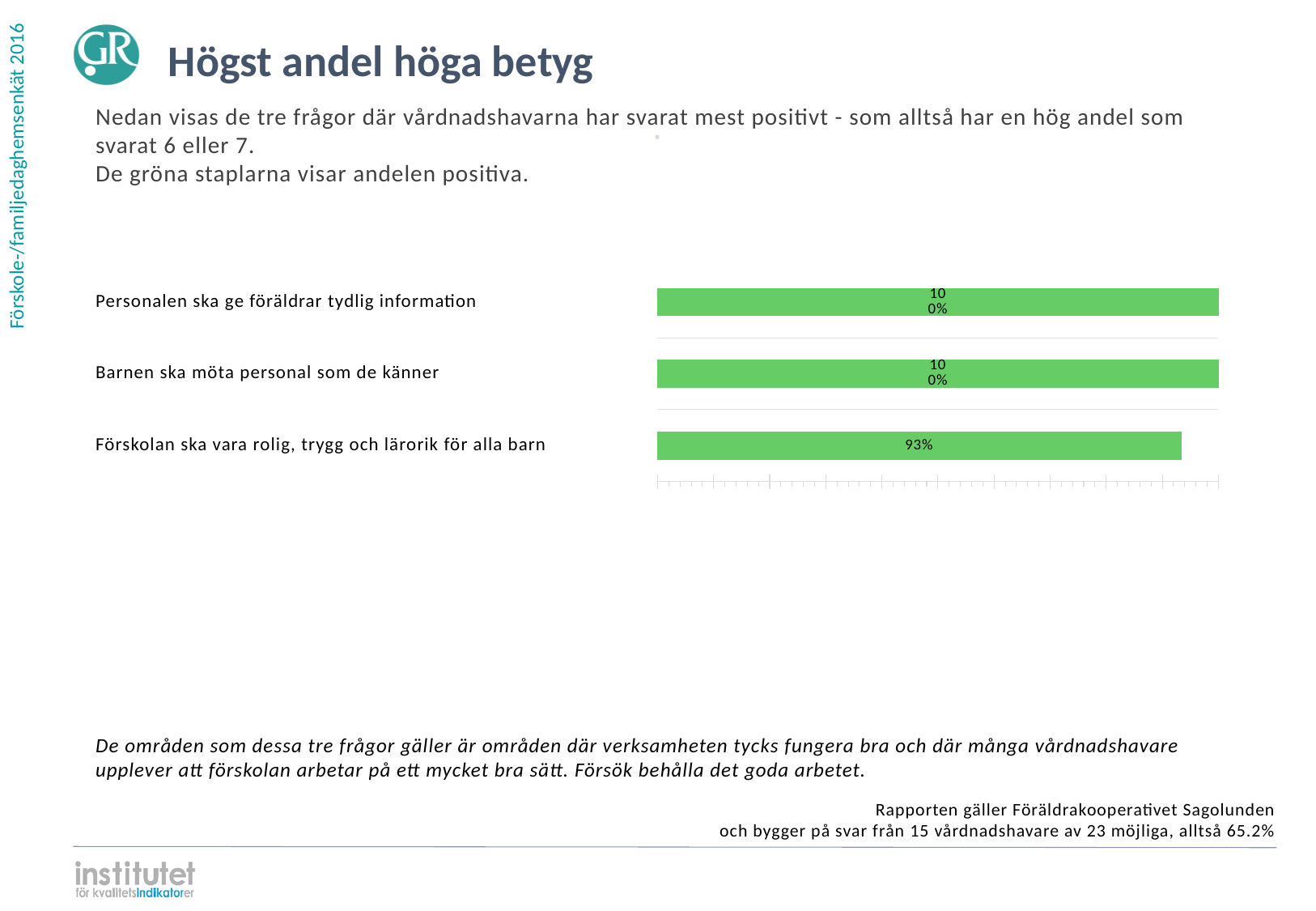
Which category has the lowest value in the chart? Förskolan ska vara rolig, trygg och lärorik för alla barn What kind of chart is shown on the slide? Bar chart What colour are the bars in the chart? Green What is the value shown for "Förskolan ska vara rolig, trygg och lärorik för alla barn"? 93% What is the difference between the value for "Personalen ska ge föräldrar tydlig information" and the value for "Förskolan ska vara rolig, trygg och lärorik för alla barn"? 7 percentage points What is the value shown for "Barnen ska möta personal som de känner"? 100% What is the value shown for "Personalen ska ge föräldrar tydlig information"? 100% How many categories are shown in the chart? 3 Do the values for "Personalen ska ge föräldrar tydlig information" and "Barnen ska möta personal som de känner" have the same value? Yes What is the title of the slide containing the chart? Högst andel höga betyg Which has the larger value: "Barnen ska möta personal som de känner" or "Förskolan ska vara rolig, trygg och lärorik för alla barn"? Barnen ska möta personal som de känner